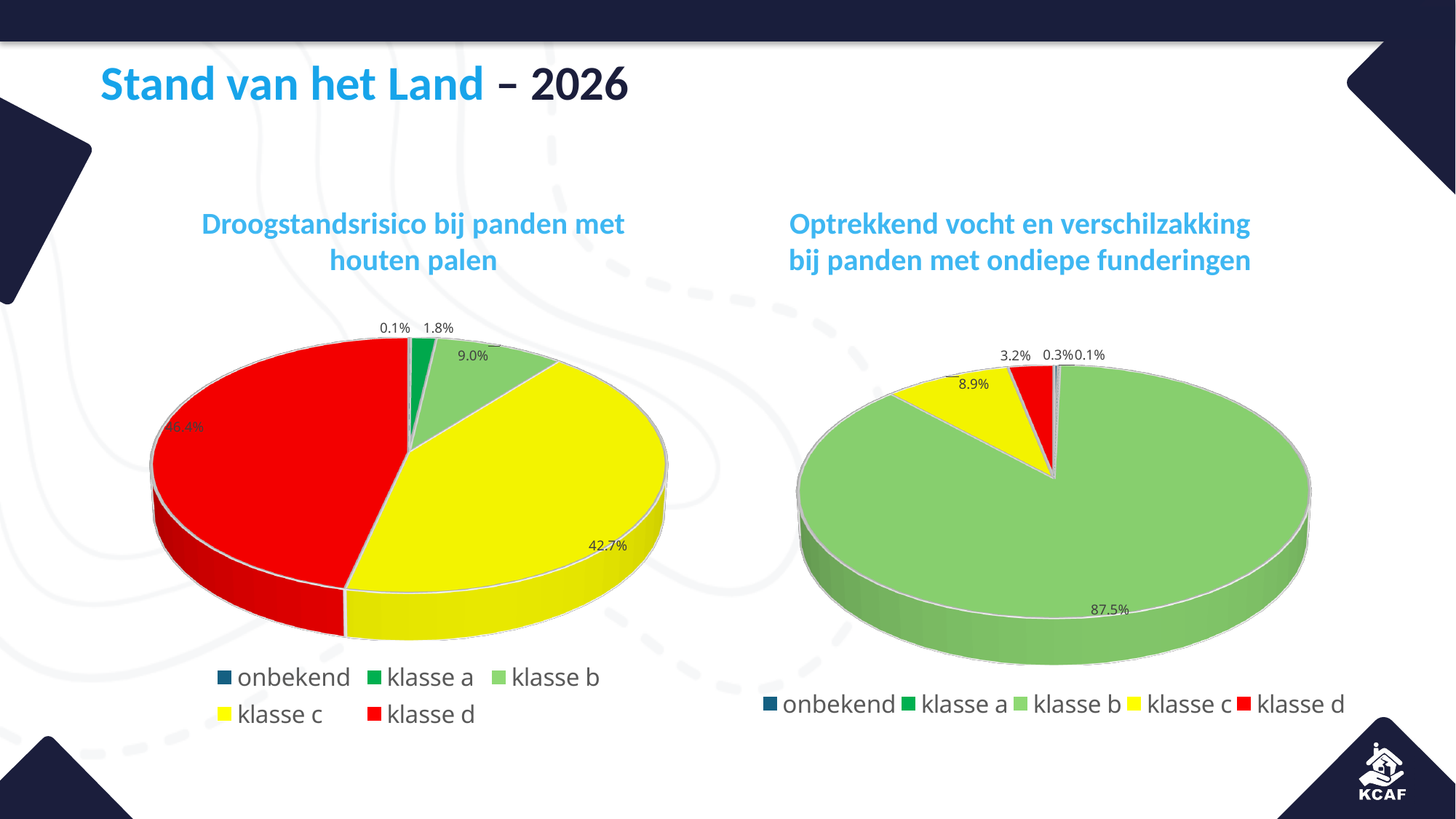
In the chart 'Optrekkend vocht en verschilzakking bij panden met ondiepe funderingen', what share does klasse c have? 8.9% How many categories does the legend of the left chart list? 5 In the chart 'Droogstandsrisico bij panden met houten palen', what share does klasse c have? 42.7% In the chart 'Optrekkend vocht en verschilzakking bij panden met ondiepe funderingen', what share does klasse d have? 3.2% In the chart 'Optrekkend vocht en verschilzakking bij panden met ondiepe funderingen', what share does klasse b have? 87.5% In the chart 'Droogstandsrisico bij panden met houten palen', what share does klasse d have? 46.4% In the chart 'Droogstandsrisico bij panden met houten palen', what share does klasse b have? 9.0% In the chart 'Droogstandsrisico bij panden met houten palen', which category has the largest slice? klasse d In the chart 'Droogstandsrisico bij panden met houten palen', what share does klasse a have? 1.8% In the chart 'Optrekkend vocht en verschilzakking bij panden met ondiepe funderingen', which category has the largest slice? klasse b In the chart 'Droogstandsrisico bij panden met houten palen', what is the difference between the shares of klasse d and klasse c? 3.7% What kind of chart is the chart on the right of the slide? pie chart